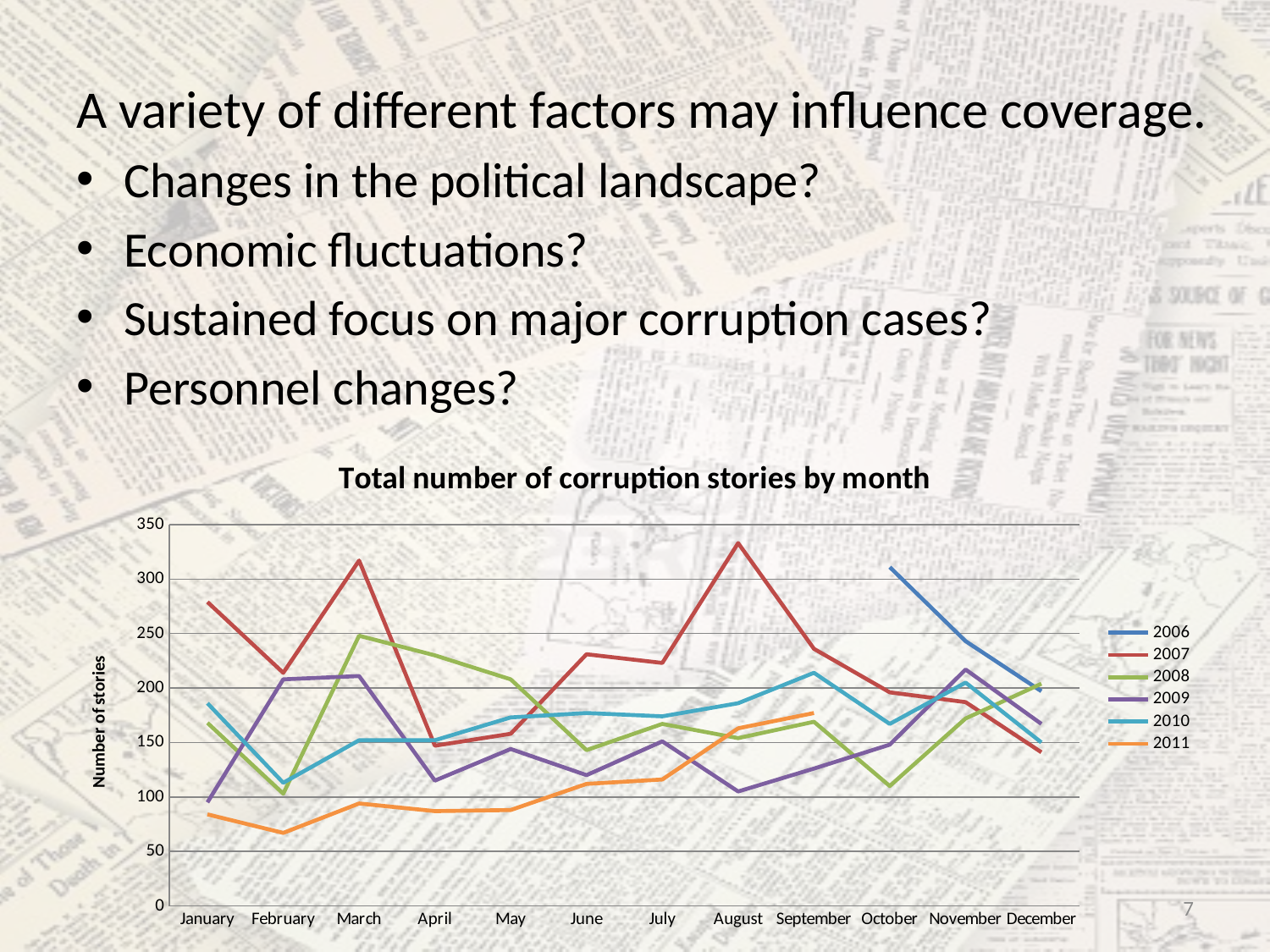
How many months are shown along the x axis of the chart? 12 In March, which series has the larger value, 2007 or 2008? 2007 In which month does the 2011 series have its lowest value? February Does the 2011 series rise or fall from May to September? Rise In which month does the 2007 series reach its highest value? August Is the value for 2011 in February greater or less than 100? less Does the 2006 series rise or fall from October to December? Fall What kind of chart is shown on the slide? Line chart What is the label on the vertical axis of the chart? Number of stories How many series does the legend of the chart list? 6 Is the value for 2007 in August greater or less than 300? greater What is the title of the chart? Total number of corruption stories by month